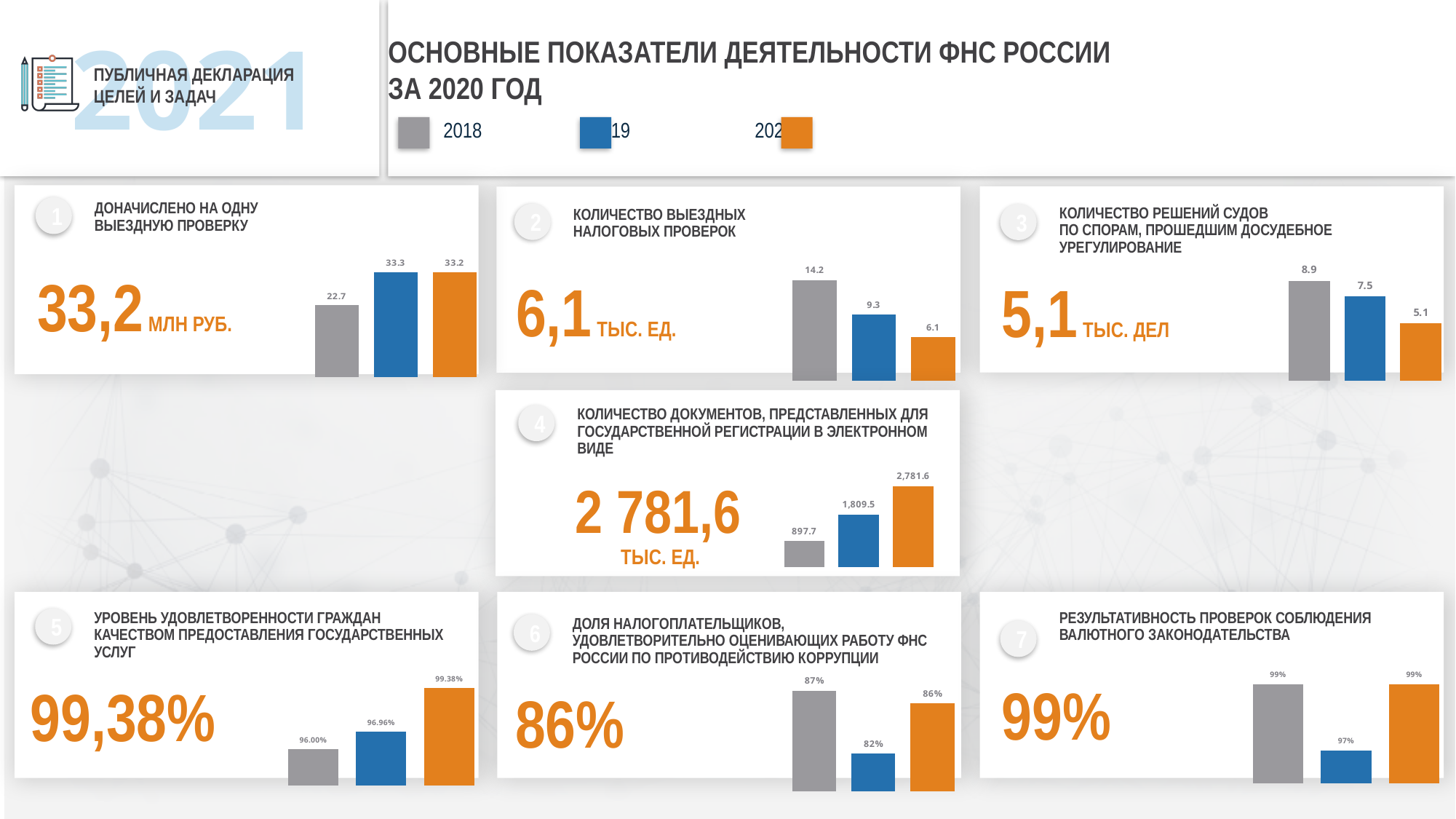
In chart 4 (Количество документов, представленных для государственной регистрации в электронном виде), which year has the lowest value? 2018 In chart 4 (Количество документов, представленных для государственной регистрации в электронном виде), what is the value for 2019? 1,809.5 In chart 3 (Количество решений судов по спорам, прошедшим досудебное урегулирование), what is the value for 2019? 7.5 In chart 6 (Доля налогоплательщиков, удовлетворительно оценивающих работу ФНС России по противодействию коррупции), which is larger, the 2018 value or the 2020 value? 2018 In chart 7 (Результативность проверок соблюдения валютного законодательства), what is the value for 2019? 97% In chart 2 (Количество выездных налоговых проверок), what is the difference between the 2018 and 2020 values? 8.1 In chart 1 (Доначислено на одну выездную проверку), what is the value for 2018? 22.7 In chart 5 (Уровень удовлетворенности граждан качеством предоставления государственных услуг), what is the value for 2019? 96.96% What type of chart is used in chart 6 (Доля налогоплательщиков, удовлетворительно оценивающих работу ФНС России по противодействию коррупции)? bar chart In chart 3 (Количество решений судов по спорам, прошедшим досудебное урегулирование), do the values rise or fall from 2018 to 2020? fall How many bars does chart 1 (Доначислено на одну выездную проверку) contain? 3 In chart 2 (Количество выездных налоговых проверок), which year has the highest value? 2018